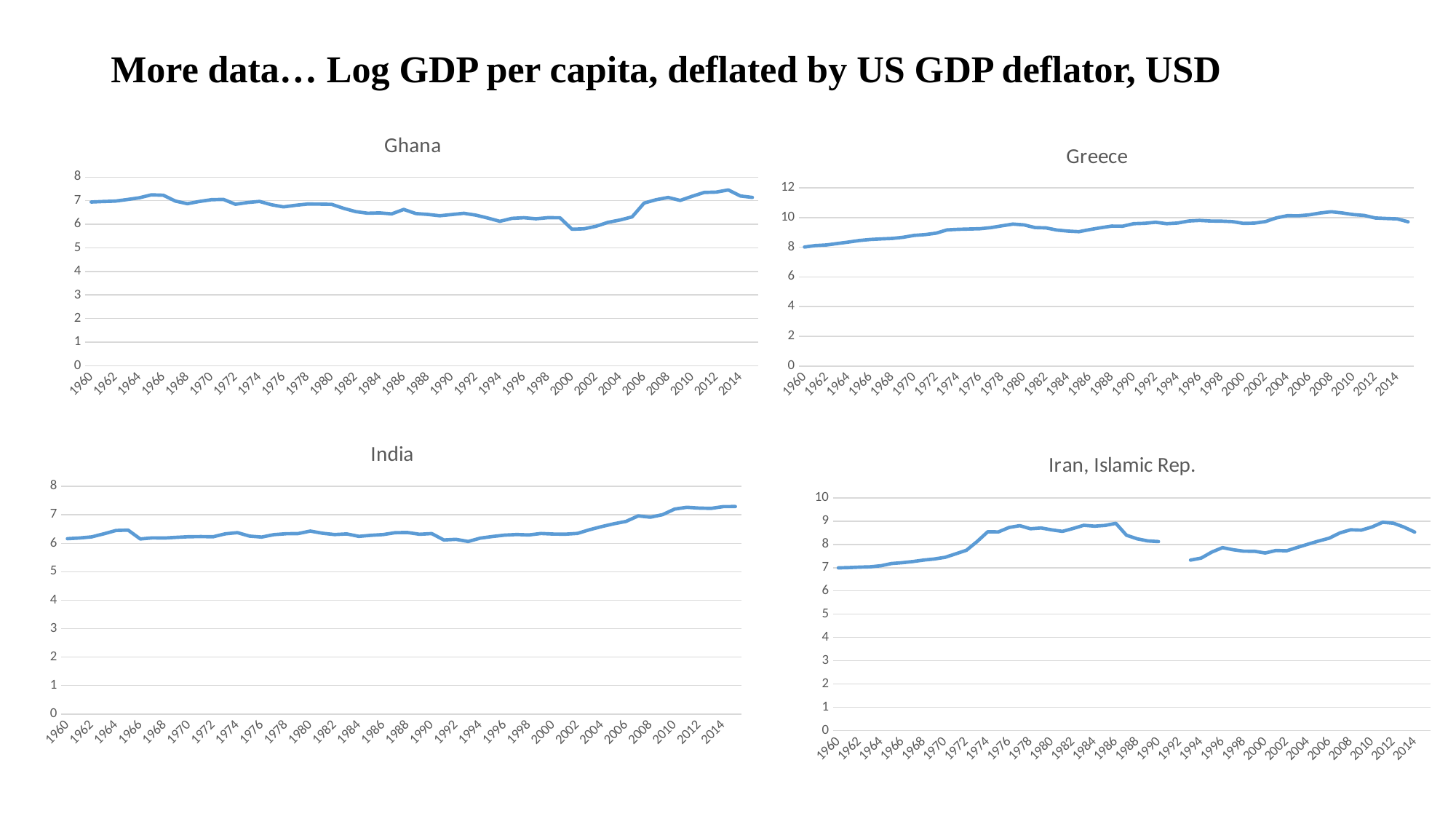
In the Greece chart, which year has the larger value, 1960 or 2014? 2014 What is the title of the bottom-right chart? Iran, Islamic Rep. In the India chart, is the value for 2014 greater or less than 7? greater In the Ghana chart, is the value for 1966 greater or less than 7? greater In the India chart, do the values generally rise or fall from 1990 to 2014? rise How many charts are shown on the slide? 4 In the Iran, Islamic Rep. chart, is the value for 1960 greater or less than 8? less What kind of chart is the Ghana chart? line chart In the Greece chart, do the values generally rise or fall from 1960 to 2014? rise Which chart shows the larger value for 2014, the Ghana chart or the Greece chart? Greece